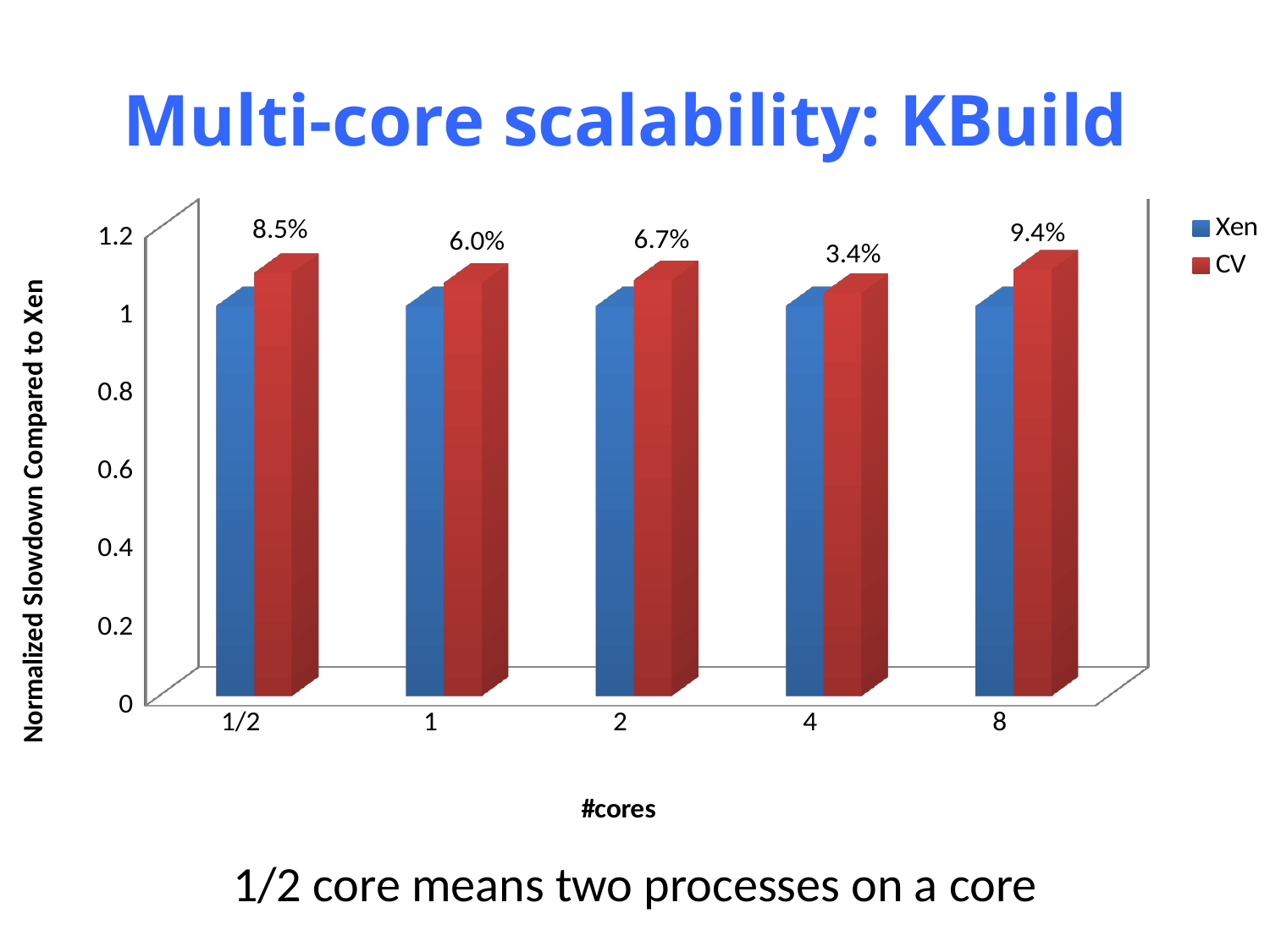
What is the difference between the percentage labels for 8 cores and 4 cores? 6.0% Which has the larger percentage label, 1 core or 2 cores? 2 cores Is the CV bar for 8 cores greater or less than 1.2 on the y axis? less How many series does the legend list? 2 Which #cores category has the lowest percentage label? 4 Which #cores category has the highest percentage label? 8 What percentage label is shown above the CV bar for 4 cores? 3.4% How many #cores categories are shown on the x axis? 5 What kind of chart is shown on the slide? bar chart Is the Xen bar for 2 cores greater or less than 0.8 on the y axis? greater What percentage label is shown above the CV bar for 1/2 core? 8.5% What percentage label is shown above the CV bar for 8 cores? 9.4%